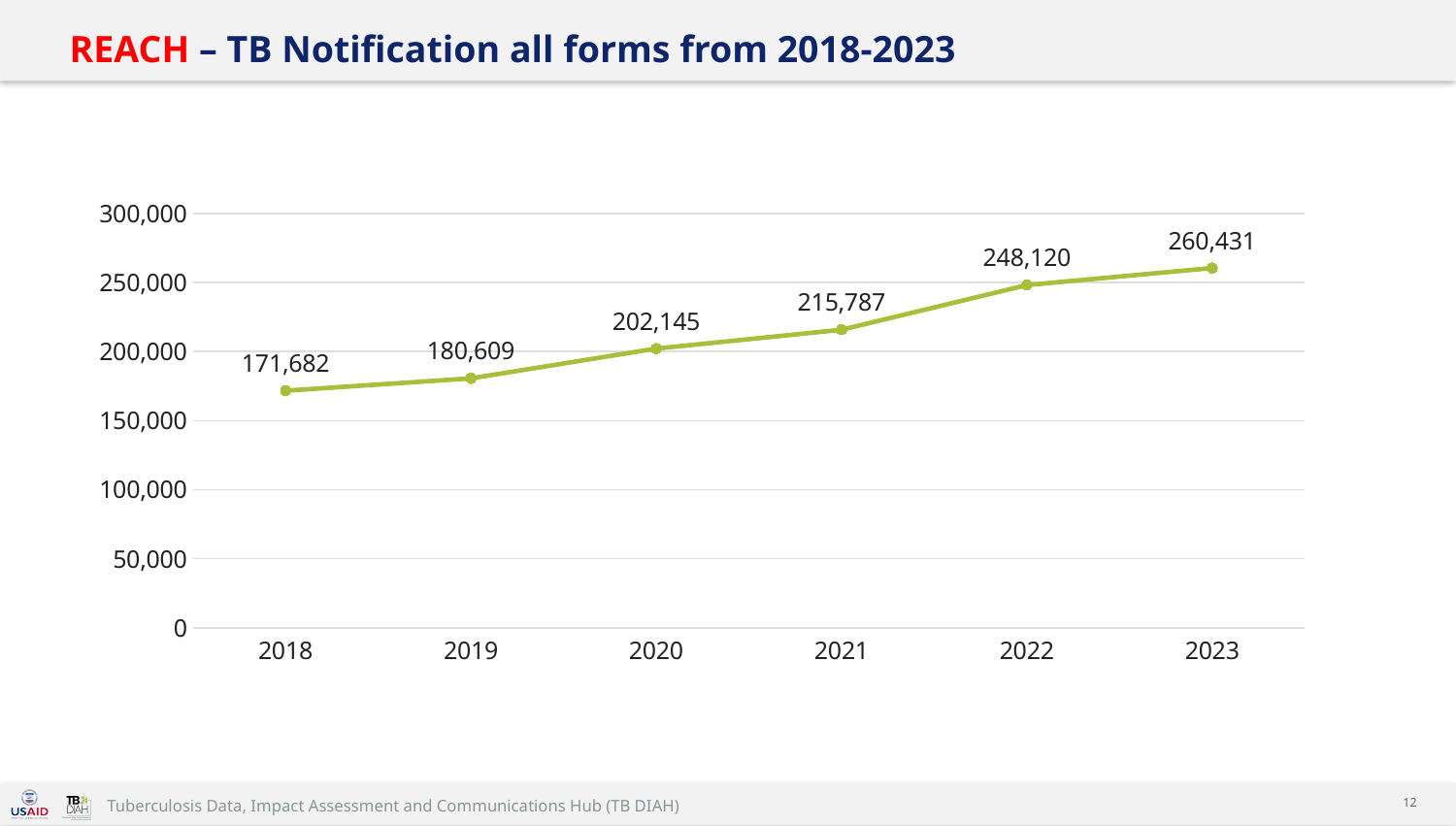
What is the TB notification value for 2018? 171,682 What is the TB notification value for 2023? 260,431 What is the difference between the 2023 and 2018 TB notification values? 88,749 How many years are plotted on the chart? 6 What kind of chart is shown on the slide? line chart Which year has the lowest TB notification value? 2018 Is the value for 2022 greater or less than 200,000? greater What is the difference between the 2022 and 2021 TB notification values? 32,333 What is the TB notification value for 2021? 215,787 Which year has the highest TB notification value? 2023 Which year has a larger TB notification value, 2019 or 2020? 2020 Do the TB notification values rise or fall from 2018 to 2023? rise